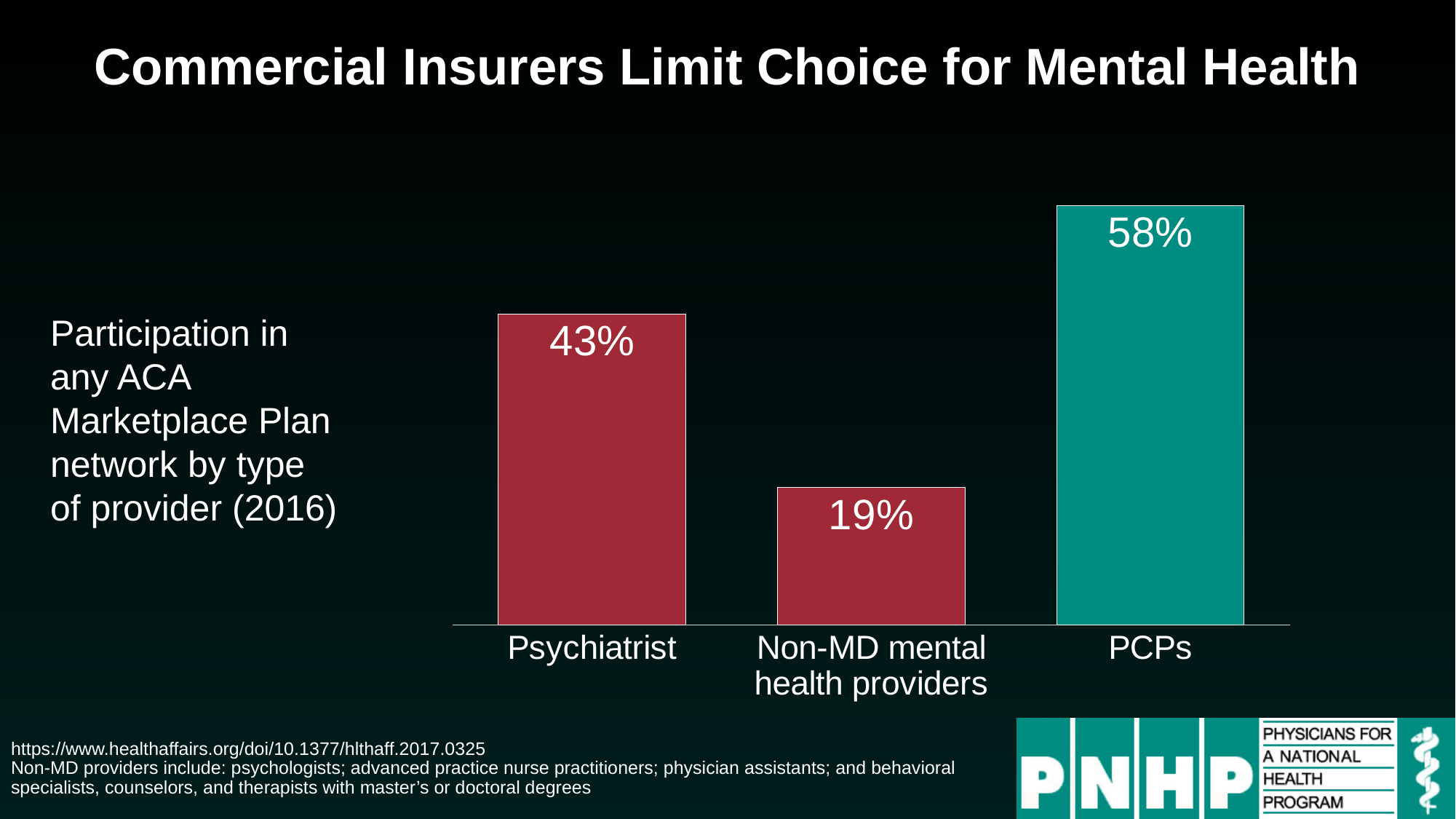
Which bar is coloured teal rather than red? PCPs How many provider categories are shown in the chart? 3 What is the title of the slide? Commercial Insurers Limit Choice for Mental Health What is the participation value for Psychiatrist? 43% Which is larger, the value for Psychiatrist or the value for Non-MD mental health providers? Psychiatrist Which provider type has the highest participation? PCPs What kind of chart is shown on the slide? Bar chart What is the difference between the PCPs value and the Psychiatrist value? 15% What is the difference between the Psychiatrist value and the Non-MD mental health providers value? 24% What is the participation value for Non-MD mental health providers? 19% What is the participation value for PCPs? 58% Which provider type has the lowest participation? Non-MD mental health providers